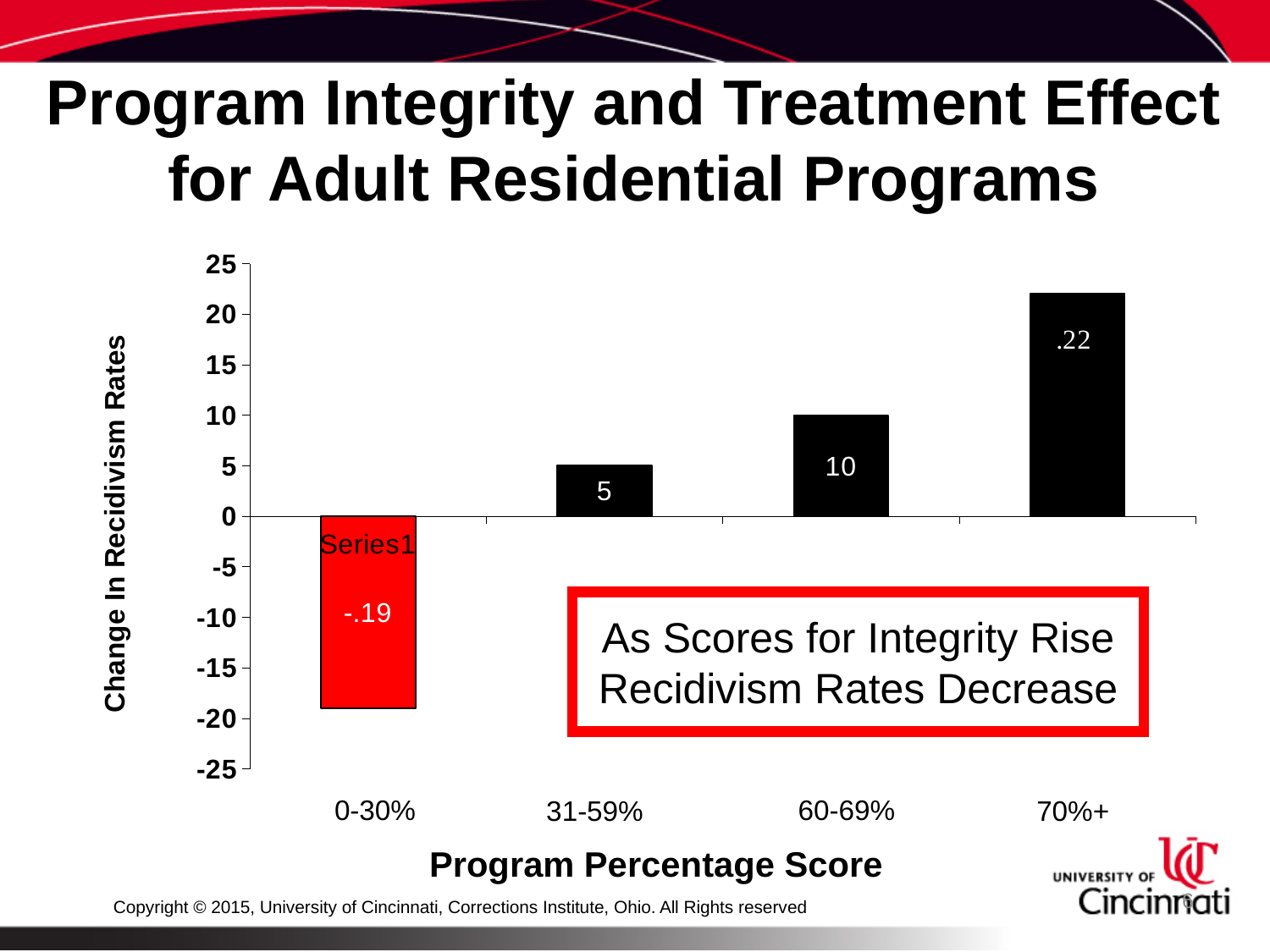
What is the value shown for the 60-69% category? 10 How many categories are shown on the x axis? 4 Which category has the lowest value? 0-30% Is the value for 70%+ greater or less than 20? greater Which is larger, the value for 60-69% or the value for 31-59%? 60-69% What is the difference between the values for 60-69% and 31-59%? 5 What kind of chart is shown on the slide? Bar chart Which category has the highest value? 70%+ What is the label of the y axis? Change In Recidivism Rates What is the value shown for the 31-59% category? 5 What is the value shown for the 70%+ category? .22 What is the value shown for the 0-30% category? -.19